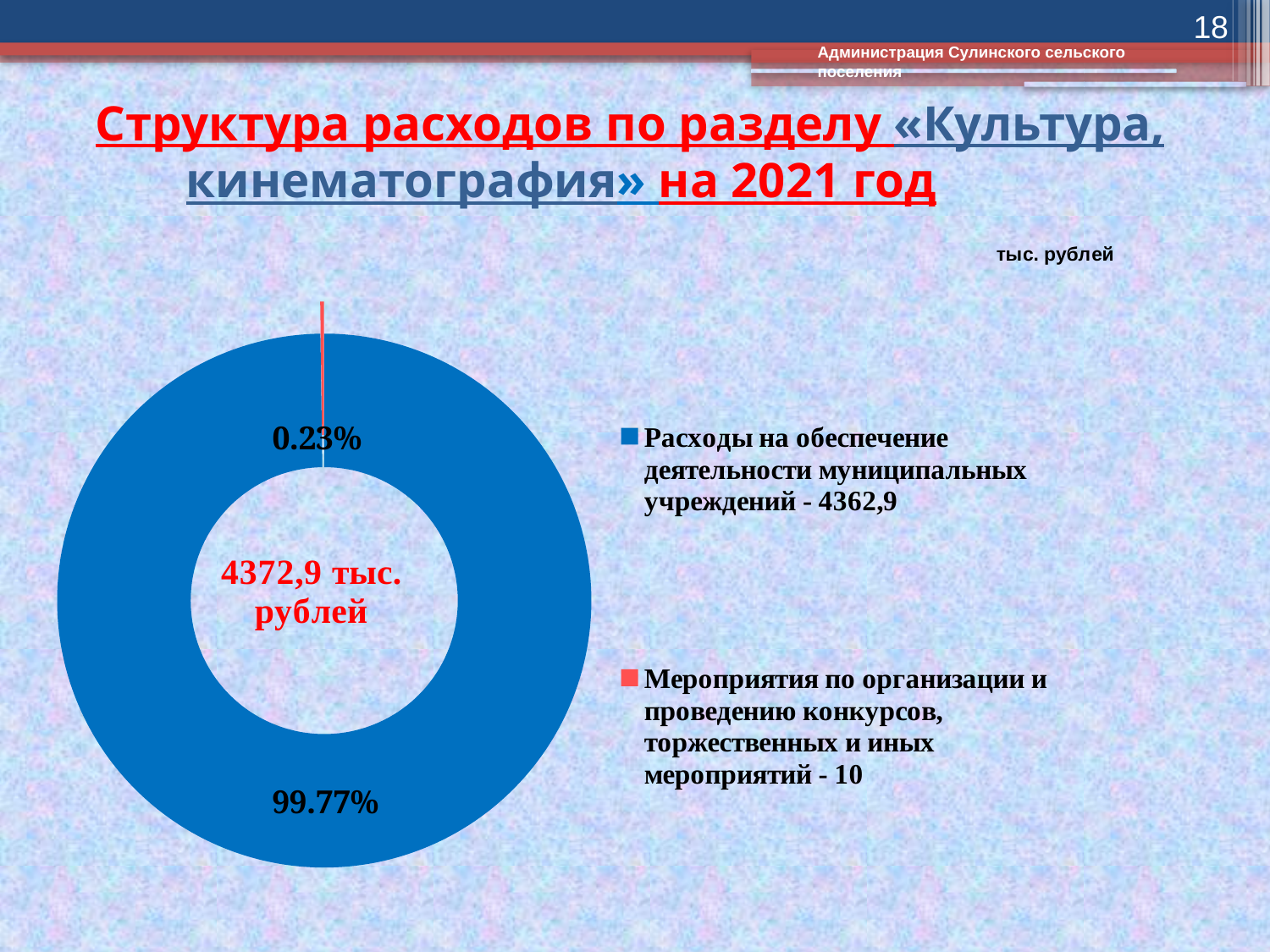
What share of the chart does the slice for «Мероприятия по организации и проведению конкурсов, торжественных и иных мероприятий» take? 0.23% Which is larger: the value for «Расходы на обеспечение деятельности муниципальных учреждений» or the value for «Мероприятия по организации и проведению конкурсов, торжественных и иных мероприятий»? Расходы на обеспечение деятельности муниципальных учреждений What share of the chart does the slice for «Расходы на обеспечение деятельности муниципальных учреждений» take? 99.77% How many categories does the chart show? 2 What value is given in the legend for «Мероприятия по организации и проведению конкурсов, торжественных и иных мероприятий»? 10 What kind of chart is shown on the slide? Doughnut chart What colour is the slice for «Мероприятия по организации и проведению конкурсов, торжественных и иных мероприятий»? Red What total amount is shown in the centre of the chart? 4372,9 тыс. рублей What value is given in the legend for «Расходы на обеспечение деятельности муниципальных учреждений»? 4362,9 Which category has the largest share of the chart? Расходы на обеспечение деятельности муниципальных учреждений Which category has the smallest share of the chart? Мероприятия по организации и проведению конкурсов, торжественных и иных мероприятий What is the difference between the two percentage shares shown on the chart? 99.54%